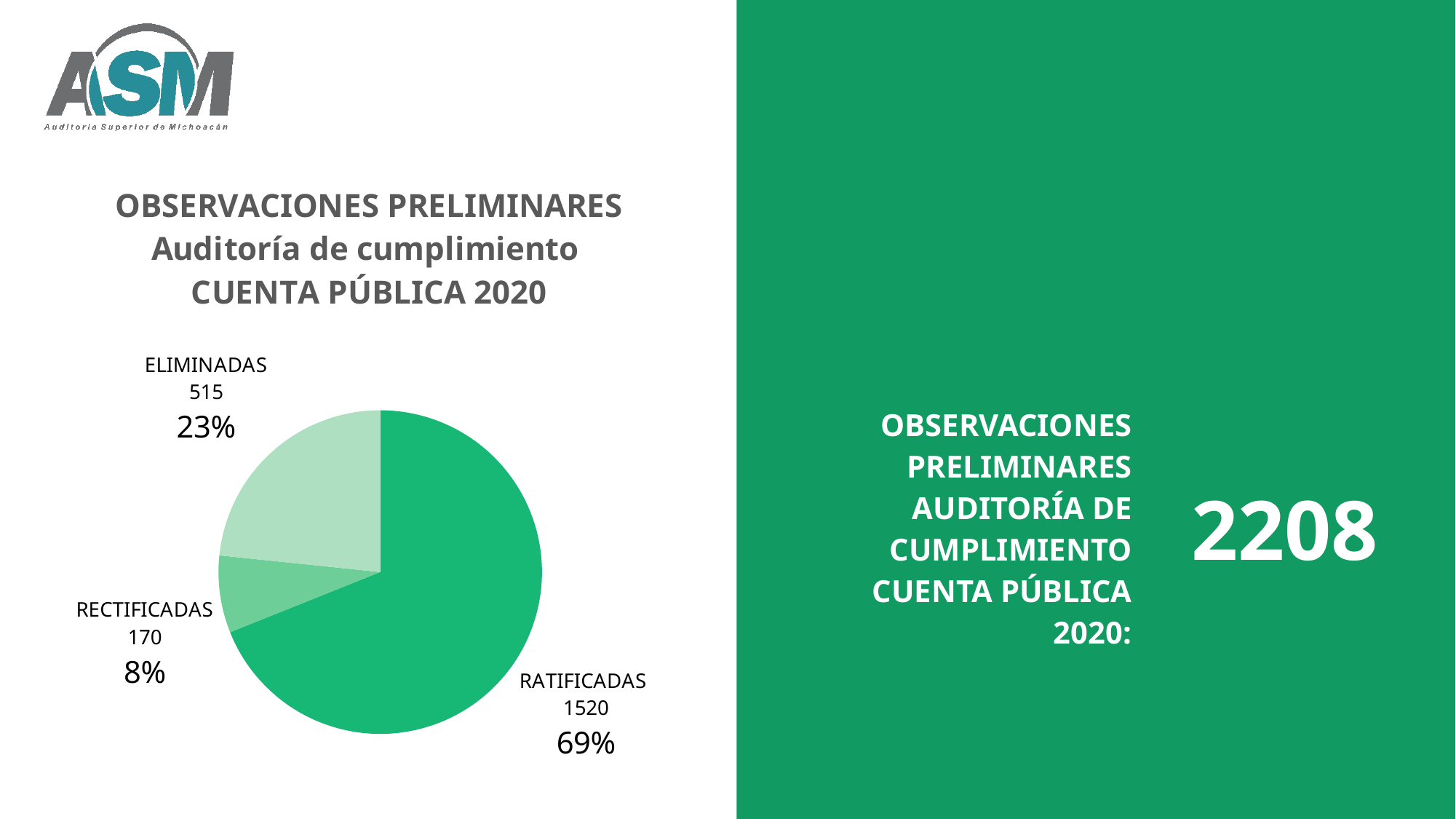
What is the value for RATIFICADAS? 1520 What is the value for RECTIFICADAS? 170 Which is larger, the value for ELIMINADAS or the value for RECTIFICADAS? ELIMINADAS What is the difference between the values for RATIFICADAS and ELIMINADAS? 1005 What share of the pie does ELIMINADAS represent? 23% What type of chart is shown on the slide? Pie chart What is the value for ELIMINADAS? 515 Which category has the smallest slice? RECTIFICADAS Which category has the largest slice? RATIFICADAS What share of the pie does RECTIFICADAS represent? 8% What is the total of the three slices in the pie chart? 2205 How many slices does the pie chart have? 3